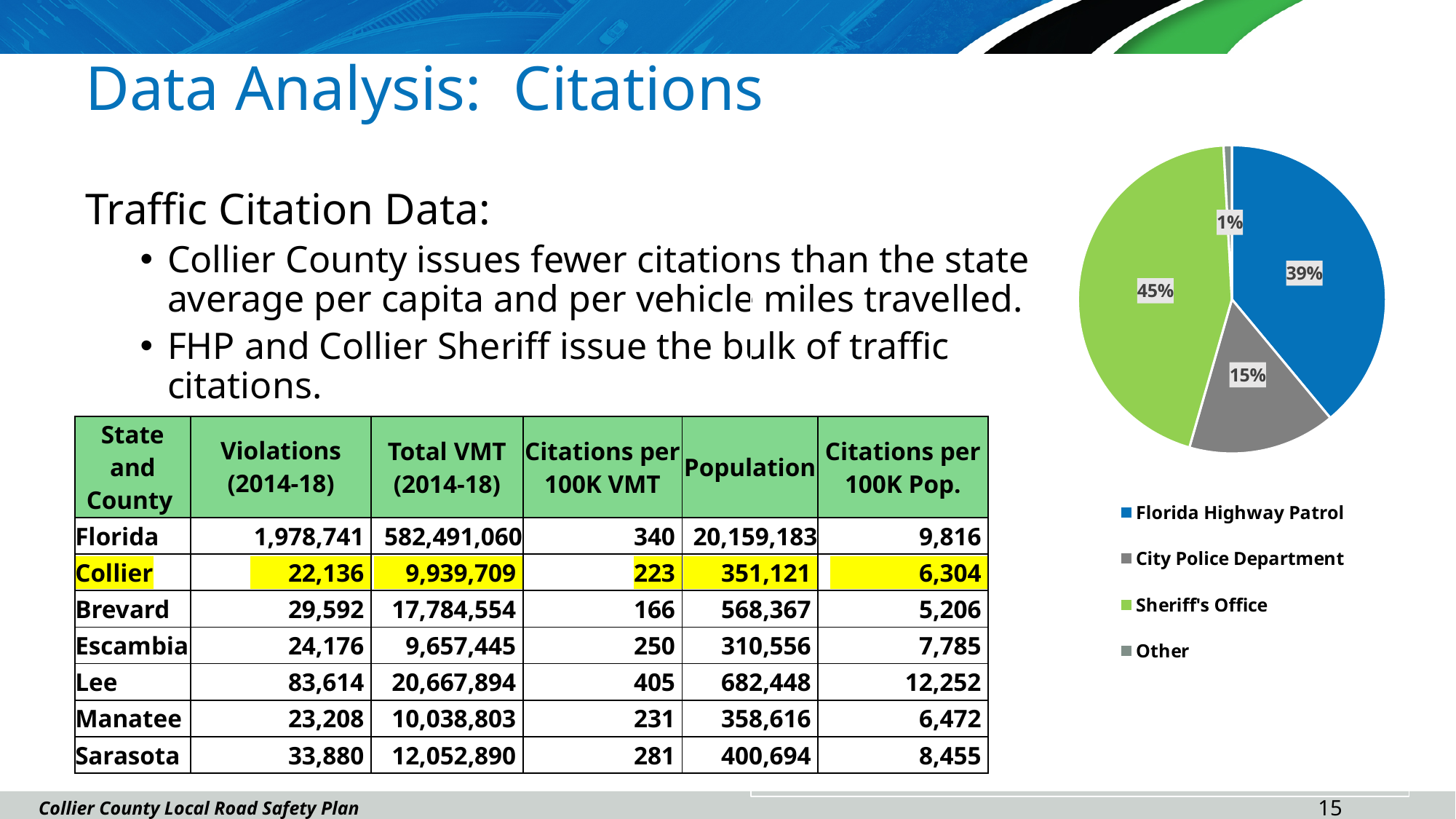
What share of the pie chart does the Florida Highway Patrol slice represent? 39% How many entries does the pie chart legend list? 4 What share of the pie chart does the City Police Department slice represent? 15% How many slices does the pie chart have? 4 Which category has the largest slice in the pie chart? Sheriff's Office What is the difference in percentage points between the Sheriff's Office slice and the Florida Highway Patrol slice? 6 What share of the pie chart does the Sheriff's Office slice represent? 45% Which category has the smallest slice in the pie chart? Other What colour is the Florida Highway Patrol slice in the pie chart? blue Which slice is larger in the pie chart, City Police Department or Florida Highway Patrol? Florida Highway Patrol What kind of chart is shown on the slide? pie chart